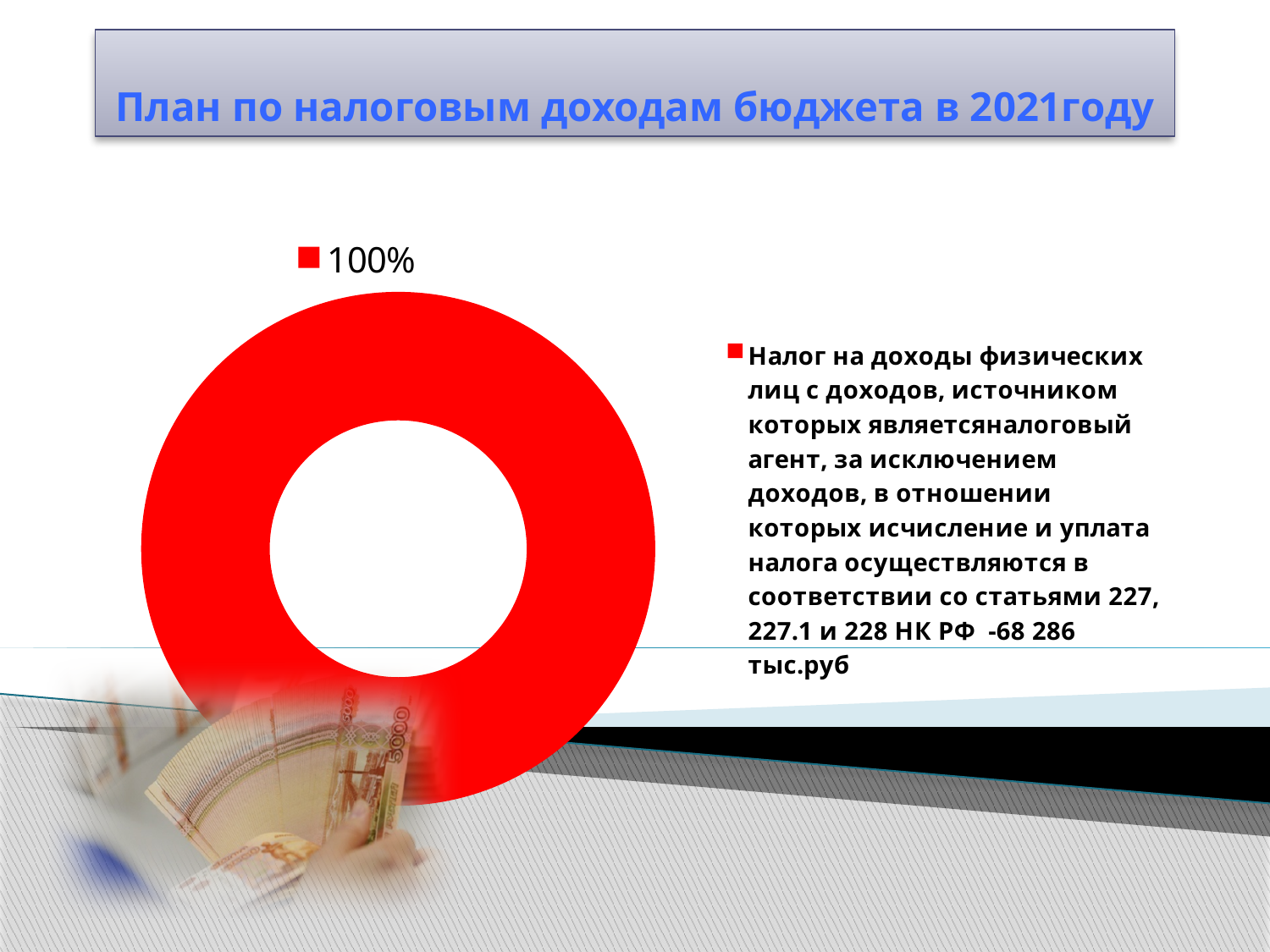
What kind of chart is shown on the slide? doughnut chart What is the title of the slide containing the chart? План по налоговым доходам бюджета в 2021году How many slices does the doughnut chart have? 1 What amount in тыс.руб is given in the legend for the personal income tax (НДФЛ) item? 68 286 тыс.руб What colour is the slice of the doughnut chart? red What is the data label shown above the doughnut chart? 100% What share of the doughnut chart does the single slice take up, according to its data label? 100% How many entries does the legend of the chart list? 1